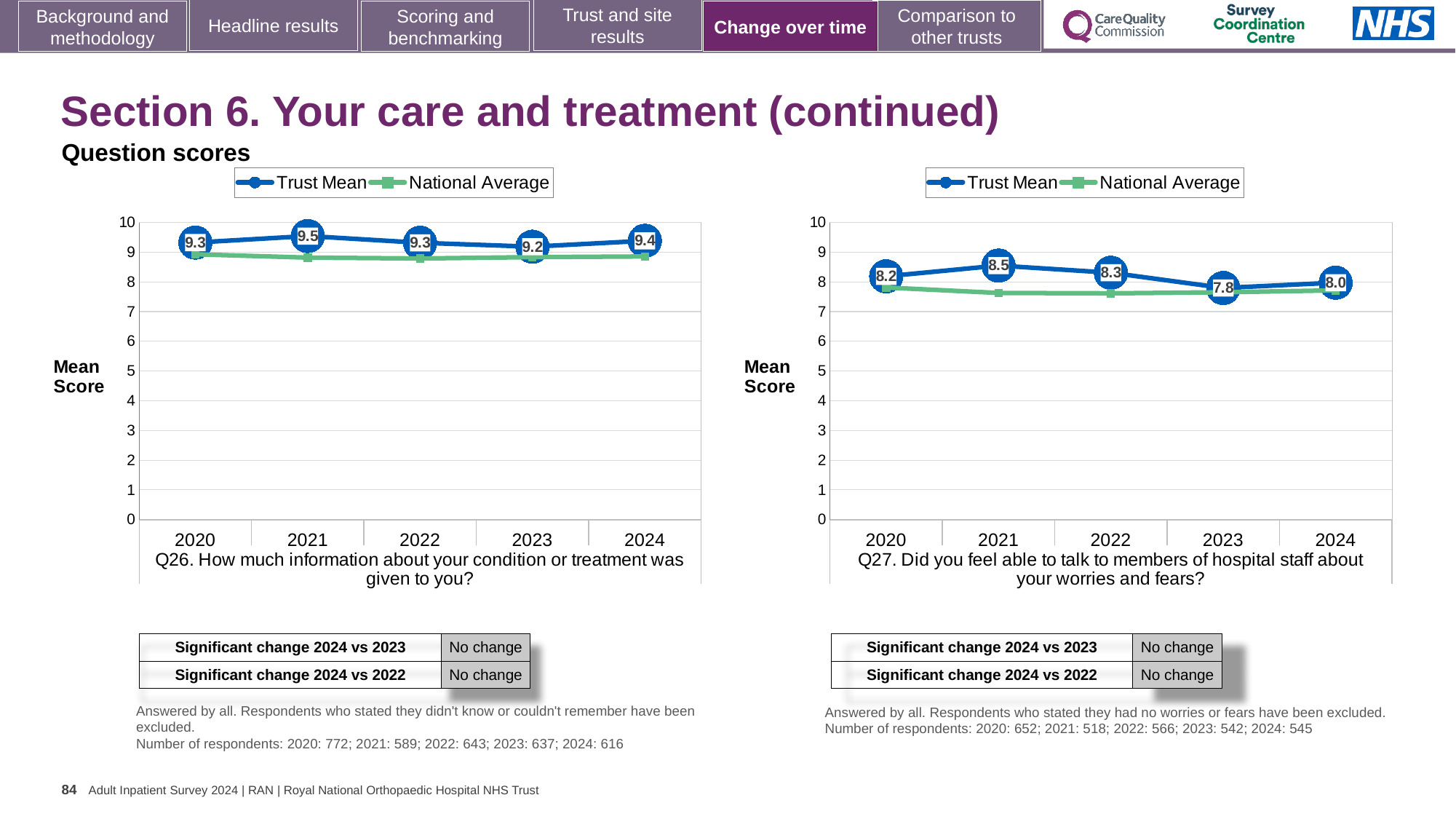
On the Q26 chart (left), what is the Trust Mean score for 2021? 9.5 On the Q27 chart (right), which year has the lowest Trust Mean score? 2023 On the Q27 chart (right), what is the difference between the Trust Mean scores for 2021 and 2023? 0.7 On the Q27 chart (right), what is the Trust Mean score for 2024? 8.0 On the Q27 chart (right), is the National Average value for 2021 greater or less than 8? less On the Q26 chart (left), what is the Trust Mean score for 2023? 9.2 On the Q26 chart (left), which year has the highest Trust Mean score? 2021 How many series does the legend of the Q26 chart (left) list? 2 On the Q26 chart (left), which year has the lowest Trust Mean score? 2023 On the Q26 chart (left), what is the difference between the Trust Mean scores for 2021 and 2023? 0.3 On the Q27 chart (right), is the Trust Mean score for 2021 greater or less than the Trust Mean score for 2022? greater What type of chart is the Q27 chart (right)? Line chart